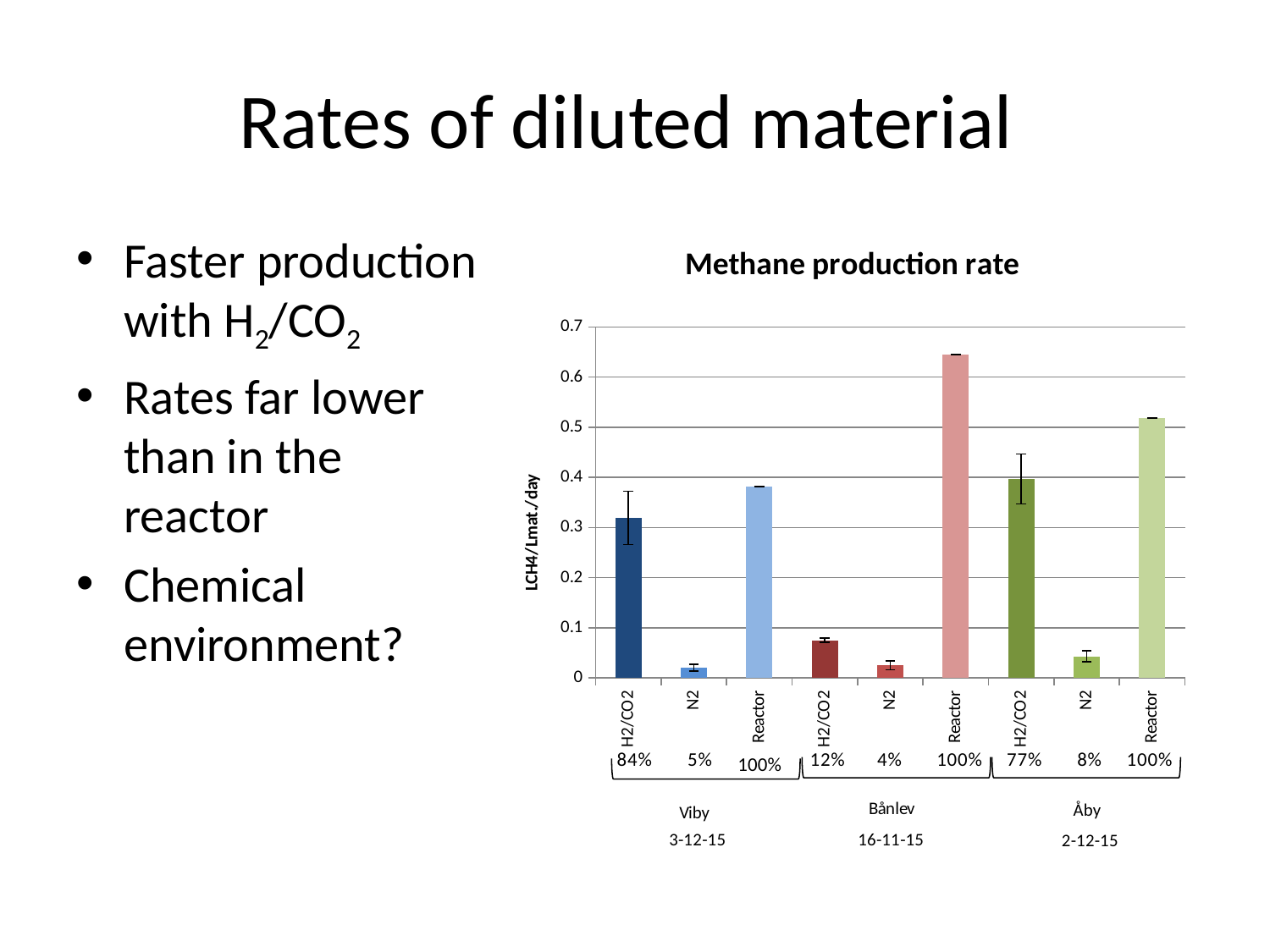
What is the title of the chart? Methane production rate Is the value for the Bånlev Reactor bar greater or less than 0.6? greater Is the value for the Åby H2/CO2 bar greater or less than 0.5? less Which is larger, the Viby Reactor bar or the Viby H2/CO2 bar? Viby Reactor Is the value for the Viby H2/CO2 bar greater or less than 0.3? greater How many bars are plotted in the chart? 9 Which is larger, the Bånlev Reactor bar or the Åby Reactor bar? Bånlev Reactor What kind of chart is shown on the slide? bar chart Which bar has the highest methane production rate? Bånlev Reactor What is the label on the vertical axis of the chart? LCH4/Lmat./day